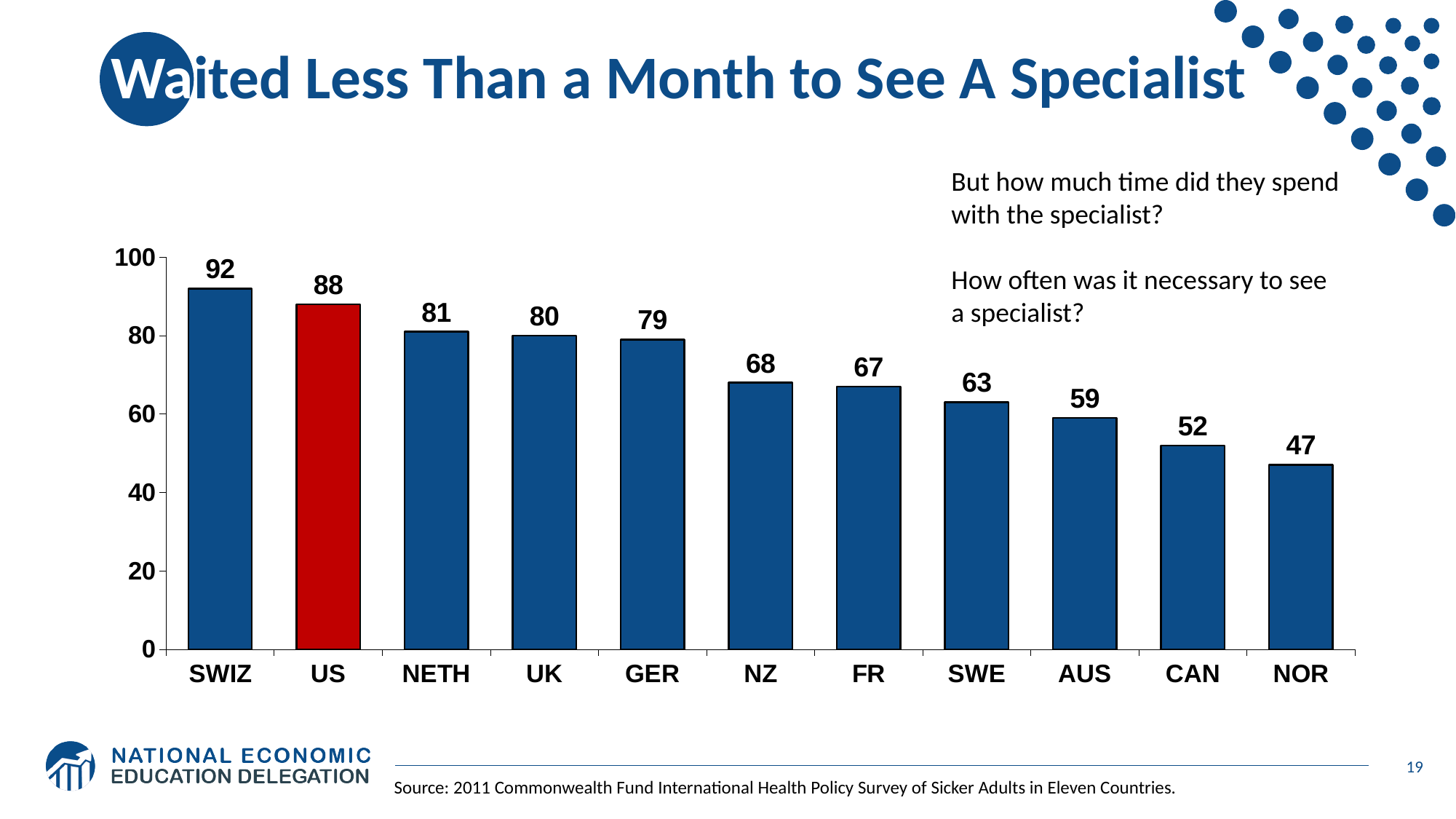
Which country has the highest value? SWIZ Is the value for AUS greater or less than 60? less What is the value for the US? 88 Which bar is coloured red rather than blue? US What is the difference between the values for SWIZ and NOR? 45 What is the difference between the values for US and NETH? 7 How many countries are shown in the chart? 11 What is the value for CAN? 52 What kind of chart is shown on the slide? bar chart Which is larger, the value for NZ or the value for SWE? NZ What is the value for GER? 79 Which country has the lowest value? NOR